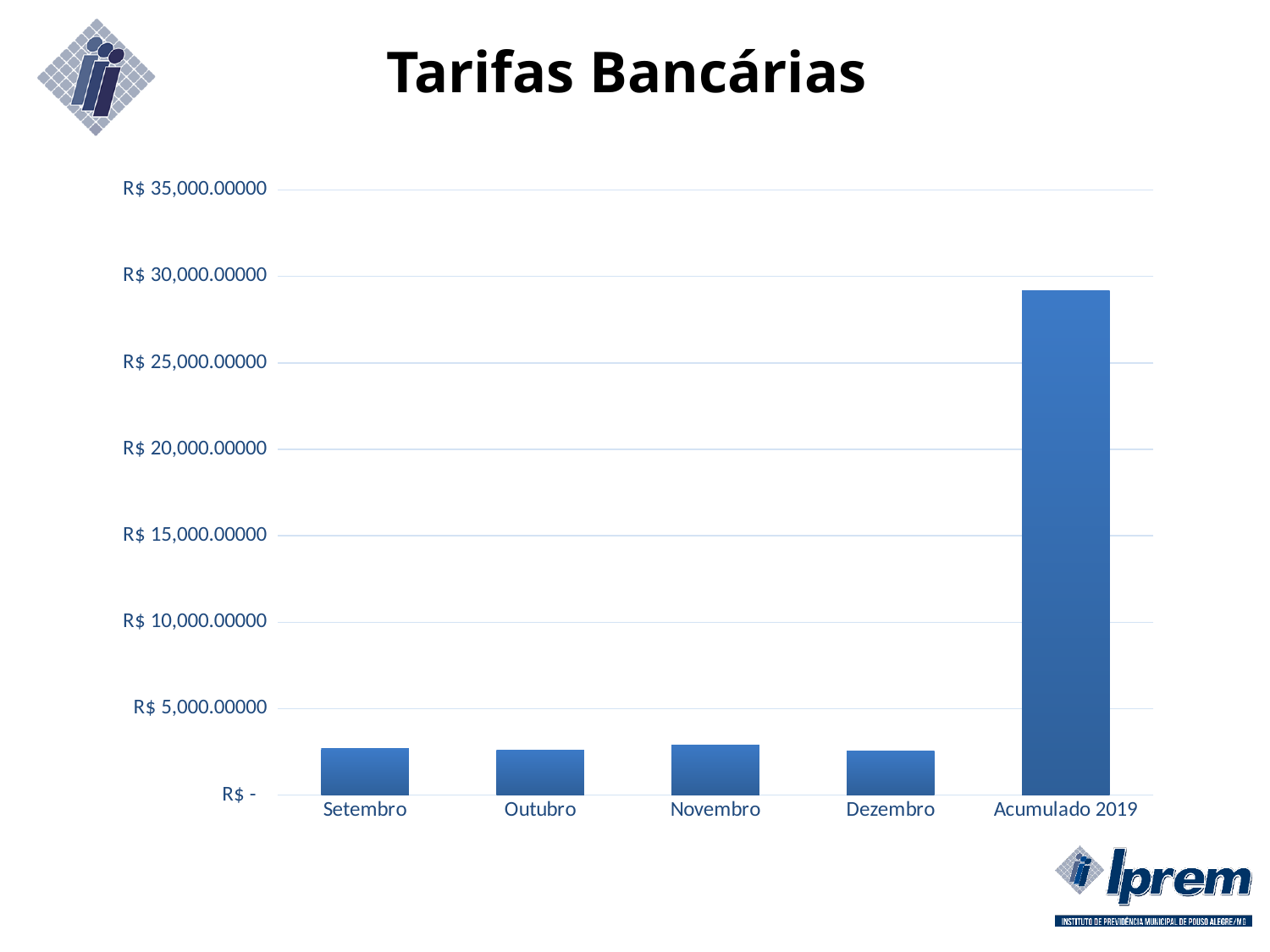
Which category has the highest value in the chart? Acumulado 2019 What is the title of the chart? Tarifas Bancárias Is the value for Dezembro greater or less than R$ 10,000.00000? less How many categories are shown on the x axis of the chart? 5 What is the label of the last category on the x axis? Acumulado 2019 Is the value for Setembro greater or less than R$ 5,000.00000? less Is the value for Acumulado 2019 greater or less than R$ 30,000.00000? less Which is larger, the value for Setembro or the value for Acumulado 2019? Acumulado 2019 What kind of chart is shown on the slide? bar chart Which is larger, the value for Acumulado 2019 or the value for Outubro? Acumulado 2019